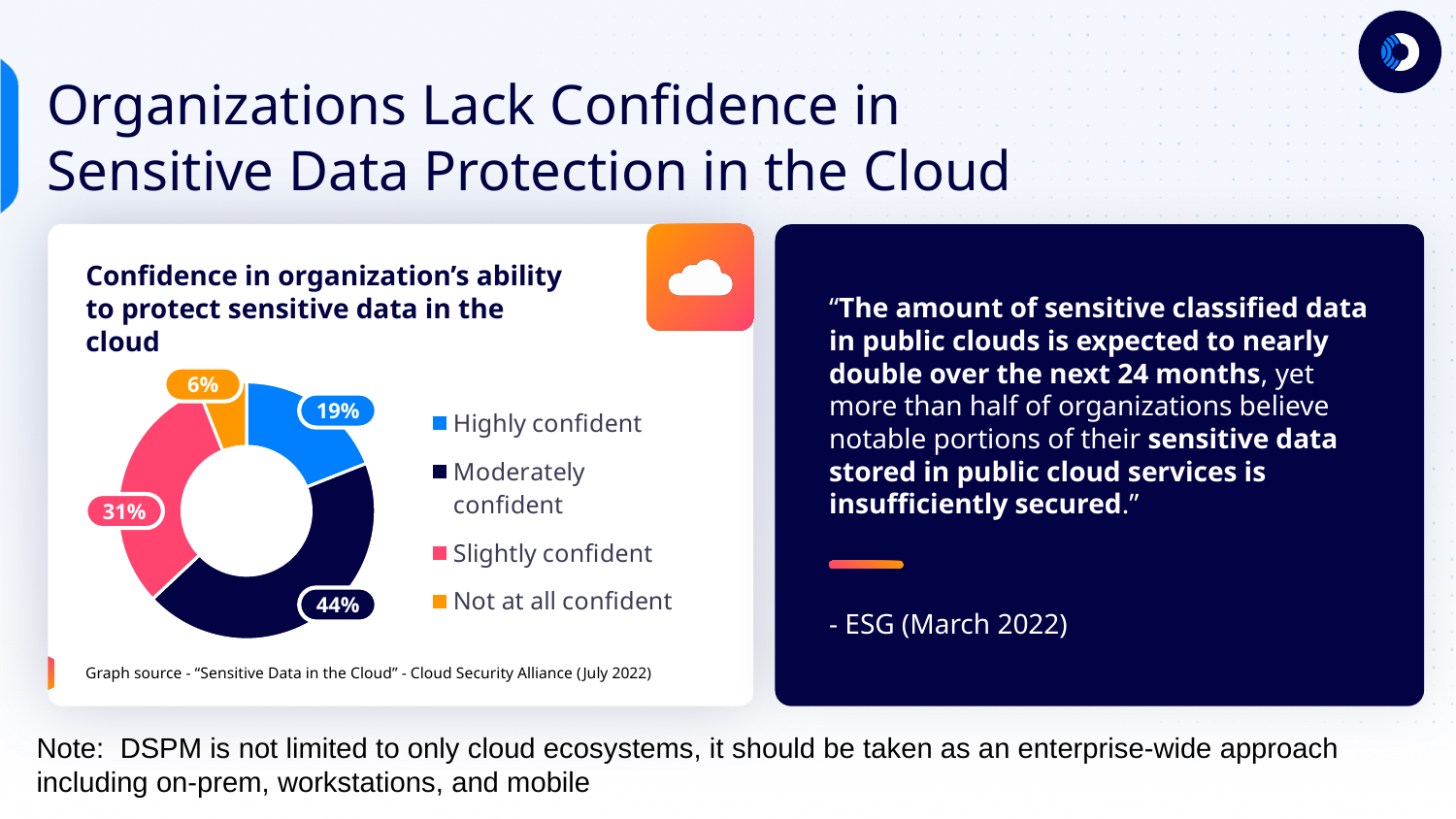
What percentage of respondents are slightly confident? 31% What percentage of respondents are moderately confident? 44% What kind of chart is shown on the slide? Doughnut chart What percentage of respondents are not at all confident? 6% Which confidence level has the largest share of the pie? Moderately confident What percentage of respondents are highly confident in their organization's ability to protect sensitive data in the cloud? 19% What is the difference in percentage points between the moderately confident and highly confident slices? 25 Which confidence level has the smallest share of the pie? Not at all confident Which is larger: the slightly confident slice or the highly confident slice? Slightly confident What colour is the slice for 'Not at all confident'? Orange What is the title of the chart? Confidence in organization's ability to protect sensitive data in the cloud How many slices does the pie chart have? 4